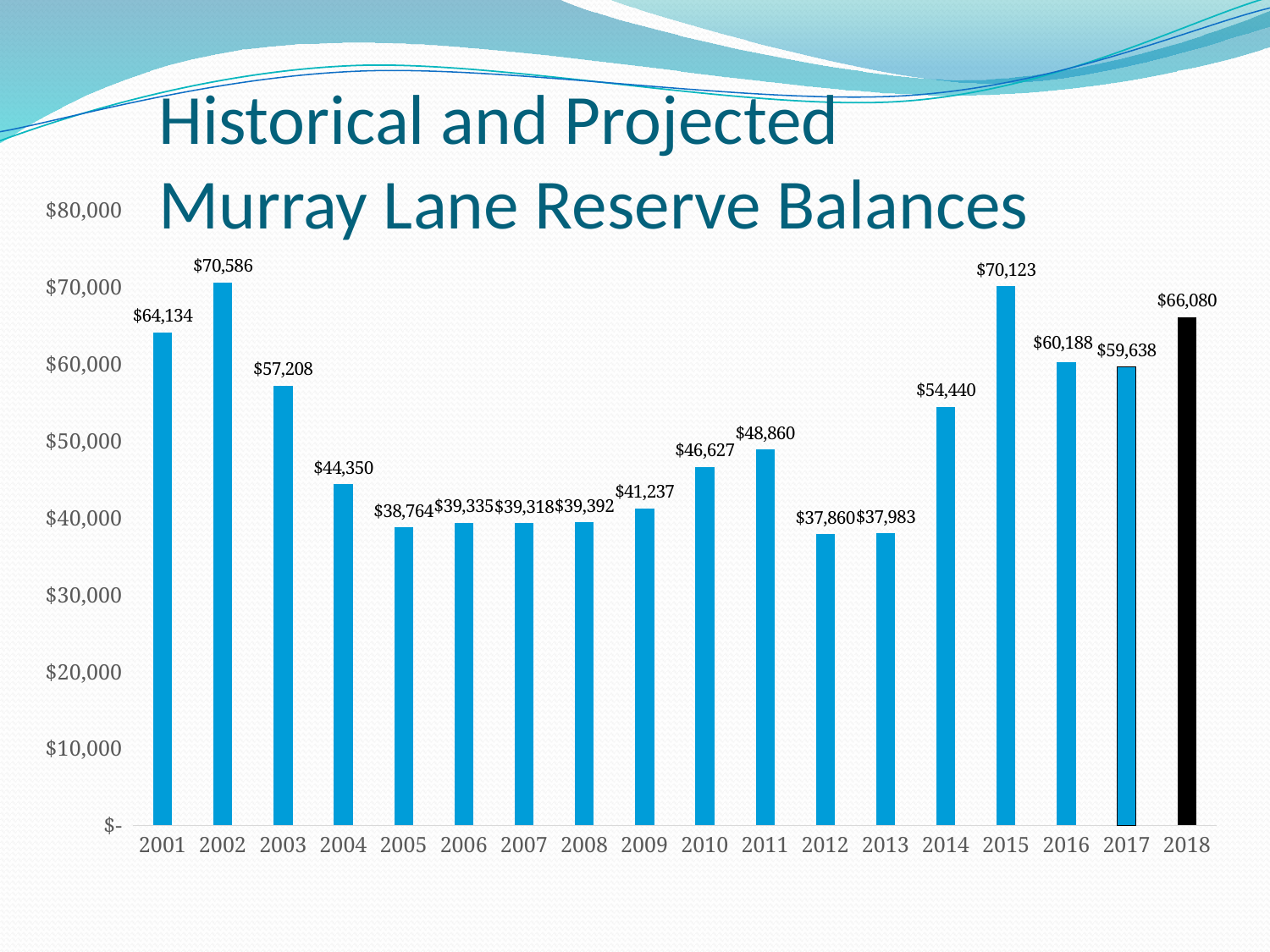
Is the value for 2014 greater or less than $50,000? greater What is the difference between the 2001 balance and the 2003 balance? $6,926 What is the difference between the 2018 balance and the 2017 balance? $6,442 Which year has the lowest reserve balance? 2012 What is the reserve balance shown for 2009? $41,237 What is the reserve balance shown for 2015? $70,123 Which year has the highest reserve balance? 2002 Which bar is coloured black rather than blue? 2018 What kind of chart is shown on the slide? bar chart Which is larger, the balance for 2010 or the balance for 2011? 2011 How many years are shown on the x axis? 18 What is the reserve balance shown for 2018? $66,080